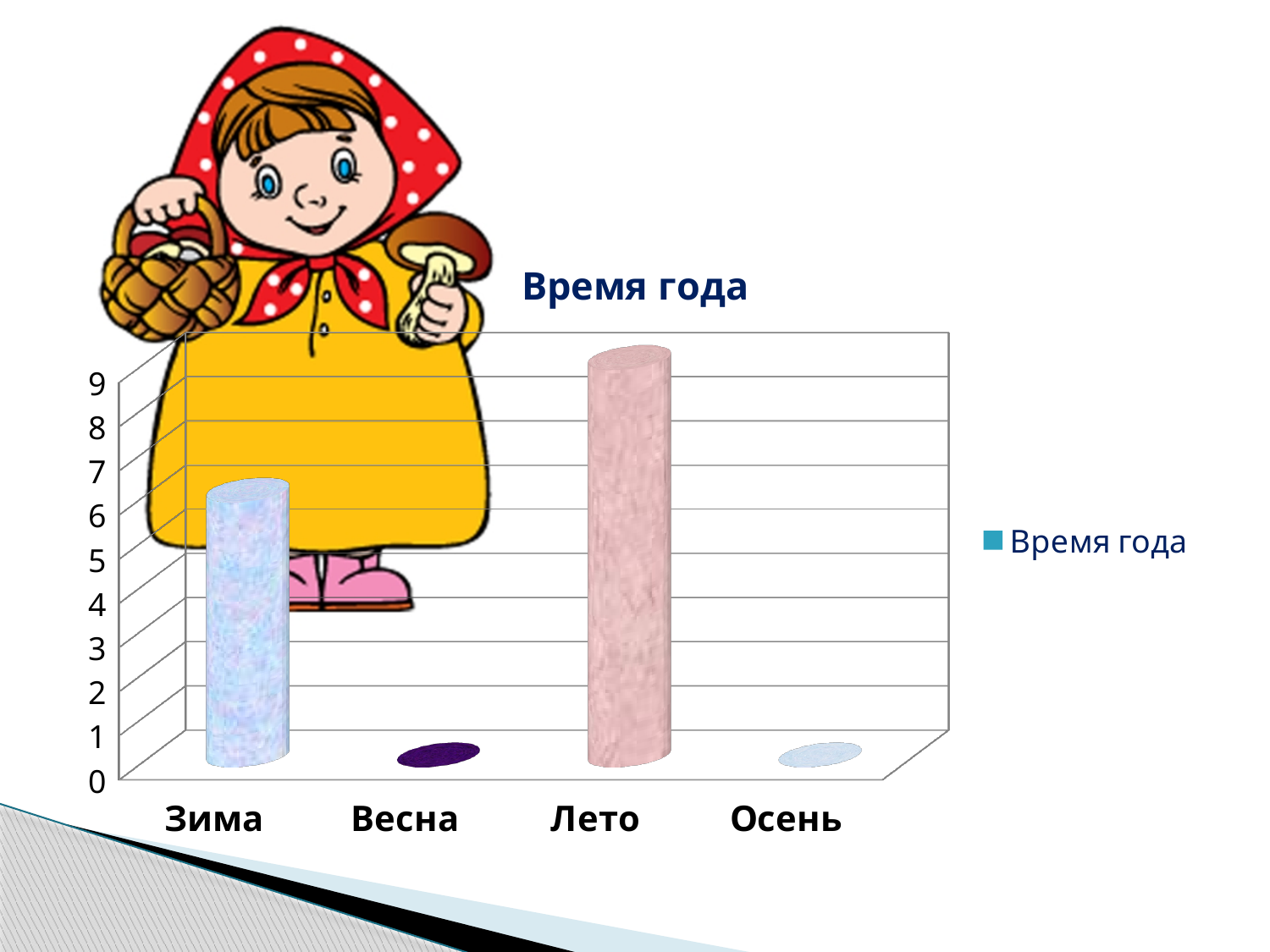
What is the title of the chart? Время года Is the value for Лето greater or less than 8? greater Is the value for Зима greater or less than 5? greater Which category has the highest value? Лето What type of chart is shown on the slide? bar chart What is the legend entry of the chart? Время года Is the value for Зима greater or less than 8? less How many categories are shown on the x axis of the chart? 4 Which is larger, the value for Зима or the value for Лето? Лето How many series does the legend list? 1